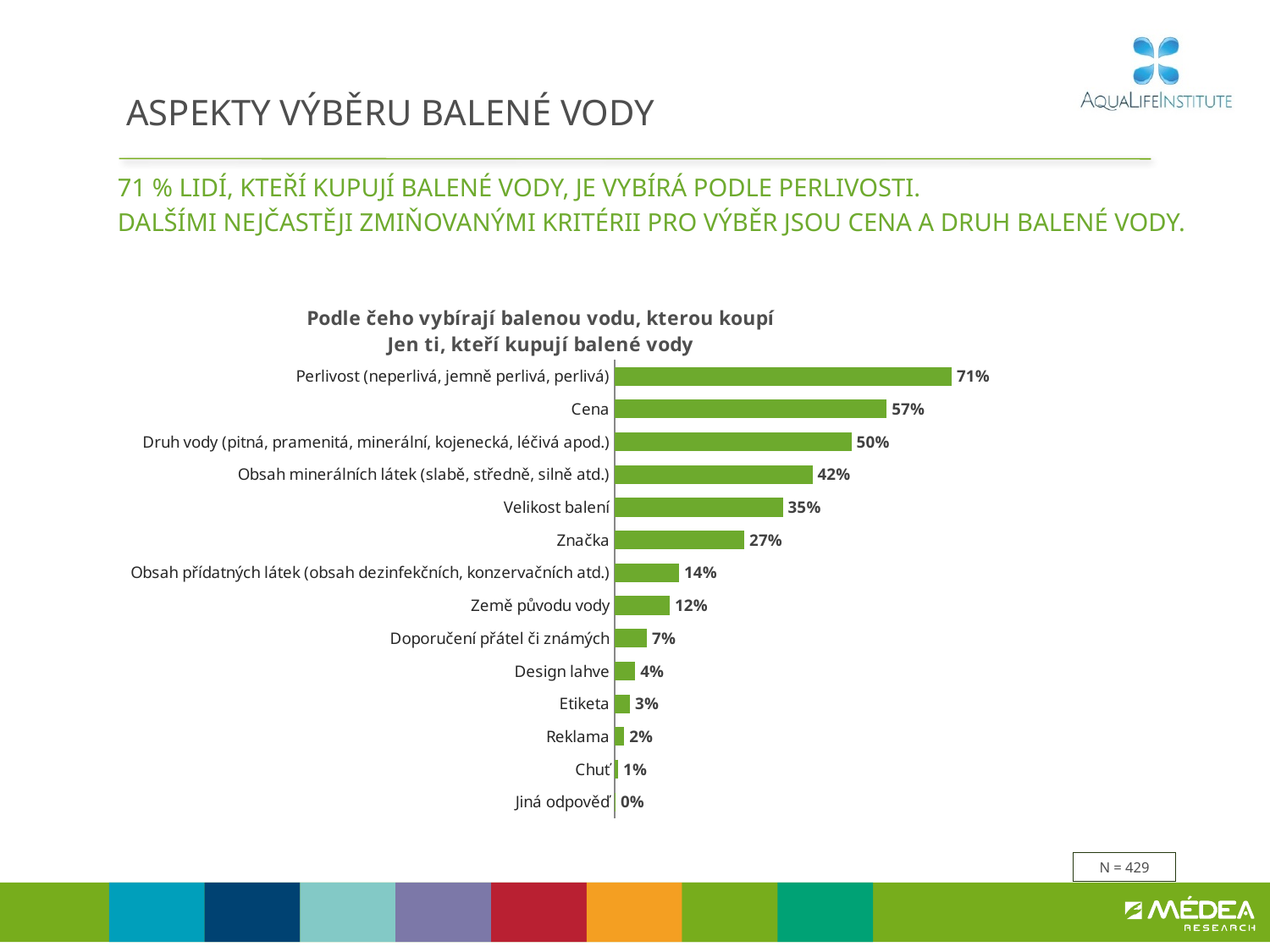
Which is larger, the value for Obsah minerálních látek (slabě, středně, silně atd.) or the value for Značka? Obsah minerálních látek (slabě, středně, silně atd.) What is the difference between the values for Značka and Design lahve? 23% What is the value for Velikost balení? 35% What is the title of the chart? Podle čeho vybírají balenou vodu, kterou koupí Jen ti, kteří kupují balené vody What is the sample size (N) shown on the slide? N = 429 Which category has the lowest value? Jiná odpověď What is the value for Země původu vody? 12% What kind of chart is shown on the slide? Bar chart How many categories are shown in the chart? 14 Which category has the highest value? Perlivost (neperlivá, jemně perlivá, perlivá) What is the value for Cena? 57% What is the difference between the values for Perlivost (neperlivá, jemně perlivá, perlivá) and Cena? 14%